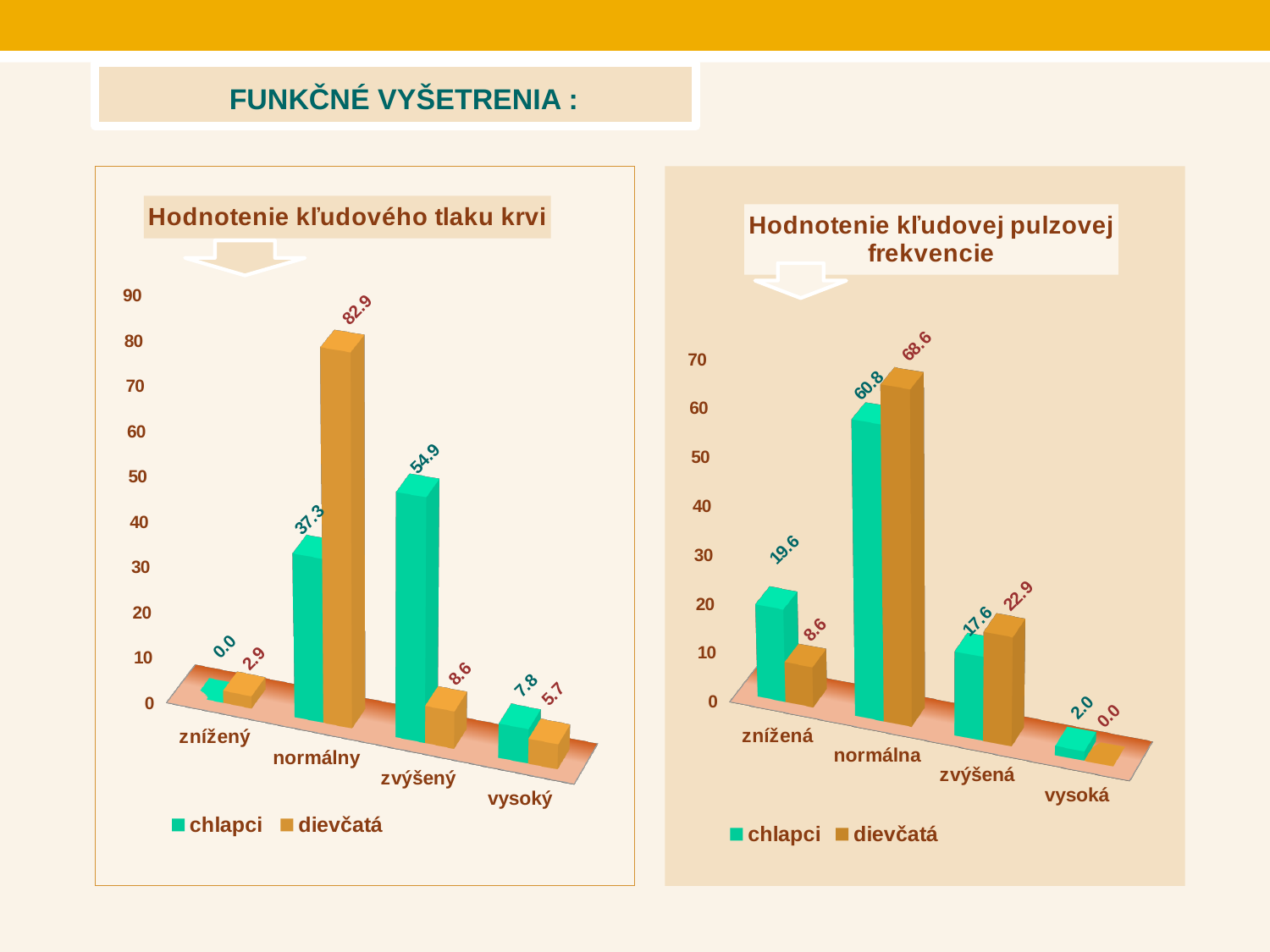
In the chart 'Hodnotenie kľudovej pulzovej frekvencie', how many series does the legend list? 2 In the chart 'Hodnotenie kľudového tlaku krvi', which category has the highest value for chlapci? zvýšený In the chart 'Hodnotenie kľudovej pulzovej frekvencie', what is the value for dievčatá in the zvýšená category? 22.9 In the chart 'Hodnotenie kľudového tlaku krvi', which is larger in the vysoký category, chlapci or dievčatá? chlapci In the chart 'Hodnotenie kľudového tlaku krvi', what is the value for dievčatá in the normálny category? 82.9 In the chart 'Hodnotenie kľudovej pulzovej frekvencie', what is the value for chlapci in the znížená category? 19.6 In the chart 'Hodnotenie kľudového tlaku krvi', what is the value for chlapci in the zvýšený category? 54.9 In the chart 'Hodnotenie kľudového tlaku krvi', what is the difference between dievčatá and chlapci in the normálny category? 45.6 What kind of chart is 'Hodnotenie kľudovej pulzovej frekvencie'? bar chart In the chart 'Hodnotenie kľudového tlaku krvi', how many categories are shown on the x axis? 4 In the chart 'Hodnotenie kľudovej pulzovej frekvencie', which category has the lowest value for dievčatá? vysoká In the chart 'Hodnotenie kľudovej pulzovej frekvencie', what is the difference between dievčatá and chlapci in the normálna category? 7.8